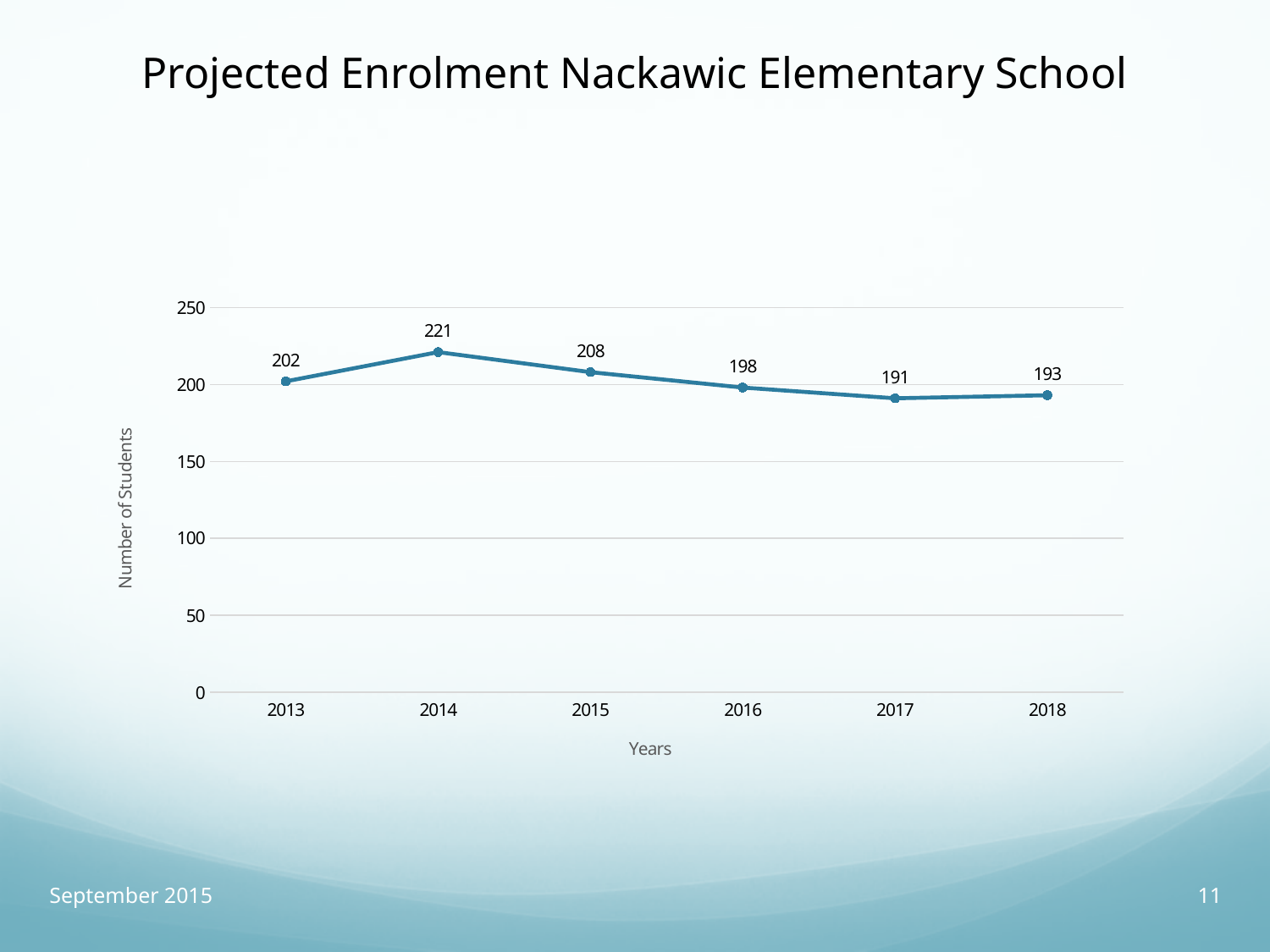
What is the projected enrolment for 2014? 221 How many years are plotted on the chart? 6 Which year has the lowest projected enrolment? 2017 What is the projected enrolment for 2017? 191 What is the projected enrolment for 2018? 193 What kind of chart is shown on the slide? line chart Which year has a higher projected enrolment, 2013 or 2016? 2013 What is the difference in projected enrolment between 2014 and 2017? 30 What is the difference in projected enrolment between 2013 and 2015? 6 Which year has the highest projected enrolment? 2014 What is the label of the vertical axis? Number of Students Is the projected enrolment for 2016 greater or less than 200? less